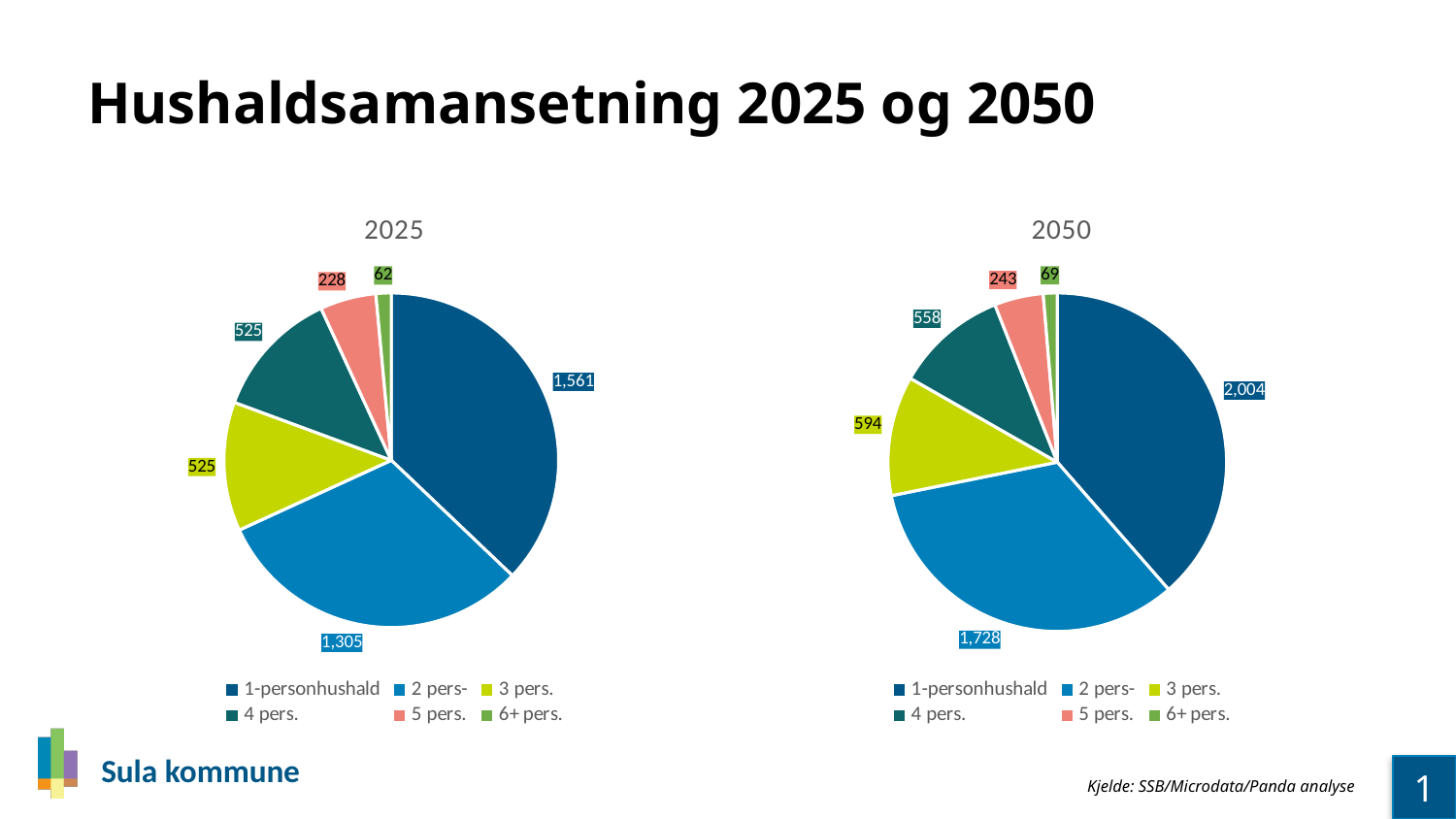
What is the title of the chart on the left? 2025 What kind of chart is the 2050 chart? Pie chart In the 2025 pie chart, what is the value for 5 pers.? 228 What is the total of all slices in the 2025 pie chart? 4,206 In the 2050 pie chart, what is the value for 6+ pers.? 69 In the 2050 pie chart, which is larger: 3 pers. or 4 pers.? 3 pers. In the 2025 pie chart, what is the value for 1-personhushald? 1,561 What is the difference between the 1-personhushald value in the 2050 chart and in the 2025 chart? 443 In the 2050 pie chart, which category has the largest slice? 1-personhushald In the 2050 pie chart, what is the value for 2 pers-? 1,728 How many slices does the 2025 pie chart have? 6 In the 2025 pie chart, which category has the smallest slice? 6+ pers.